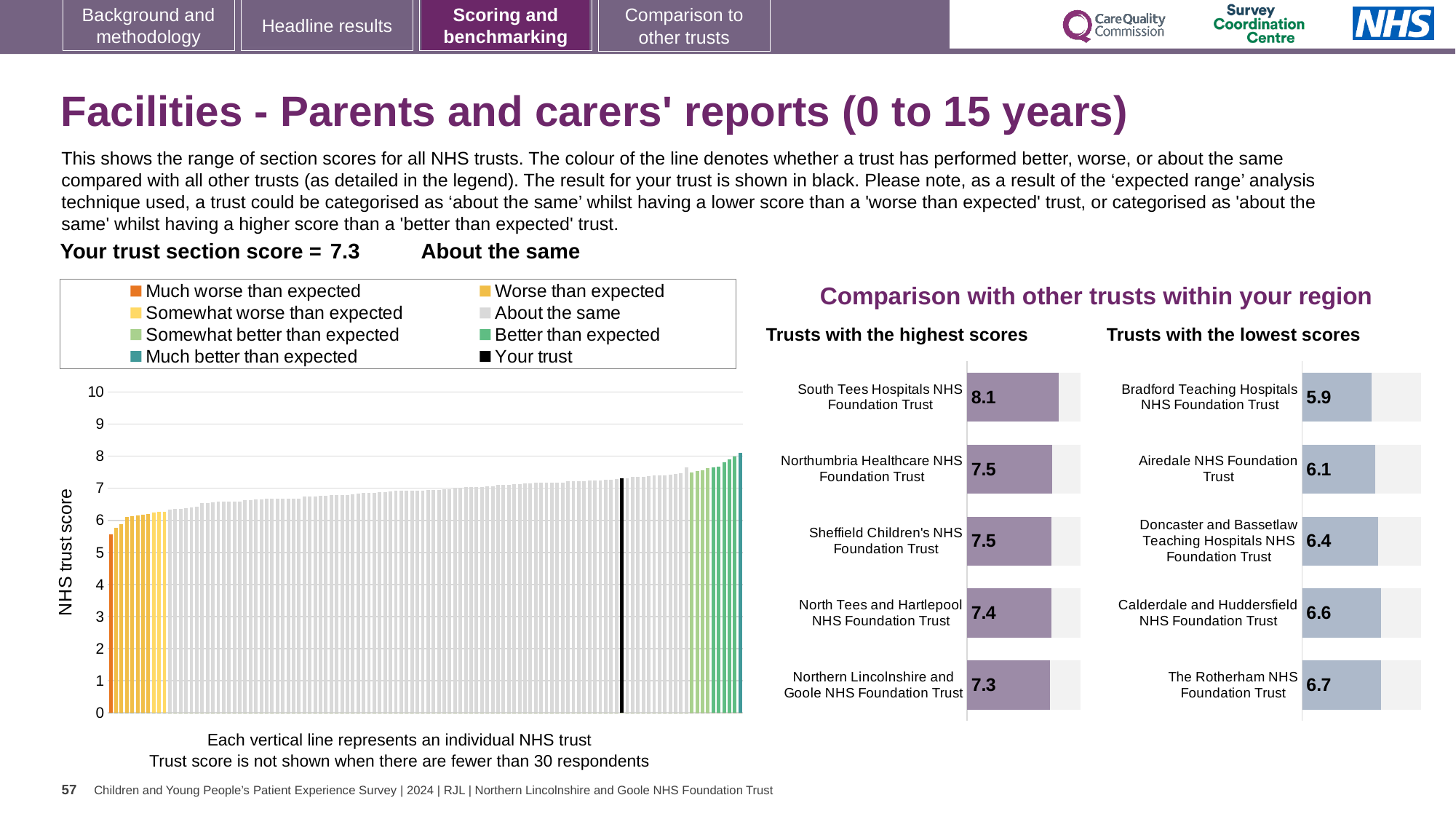
In the 'Trusts with the lowest scores' chart, which has the larger score: Calderdale and Huddersfield NHS Foundation Trust or Airedale NHS Foundation Trust? Calderdale and Huddersfield NHS Foundation Trust How many entries does the legend of the large chart on the left list? 8 In the 'Trusts with the lowest scores' chart, what is the score for Bradford Teaching Hospitals NHS Foundation Trust? 5.9 In the 'Trusts with the highest scores' chart, what is the difference between the scores of South Tees Hospitals NHS Foundation Trust and Northern Lincolnshire and Goole NHS Foundation Trust? 0.8 How many trusts are shown in the 'Trusts with the highest scores' chart? 5 In the large chart on the left showing all NHS trusts, do the bar heights rise or fall from left to right? rise In the 'Trusts with the lowest scores' chart, what is the score for Doncaster and Bassetlaw Teaching Hospitals NHS Foundation Trust? 6.4 In the 'Trusts with the highest scores' chart, which trust has the highest score? South Tees Hospitals NHS Foundation Trust In the 'Trusts with the lowest scores' chart, which trust has the lowest score? Bradford Teaching Hospitals NHS Foundation Trust In the large chart on the left showing all NHS trusts, what is the score for your trust (the black bar)? 7.3 In the 'Trusts with the lowest scores' chart, what is the difference between the scores of The Rotherham NHS Foundation Trust and Airedale NHS Foundation Trust? 0.6 In the 'Trusts with the highest scores' chart, what is the score for South Tees Hospitals NHS Foundation Trust? 8.1